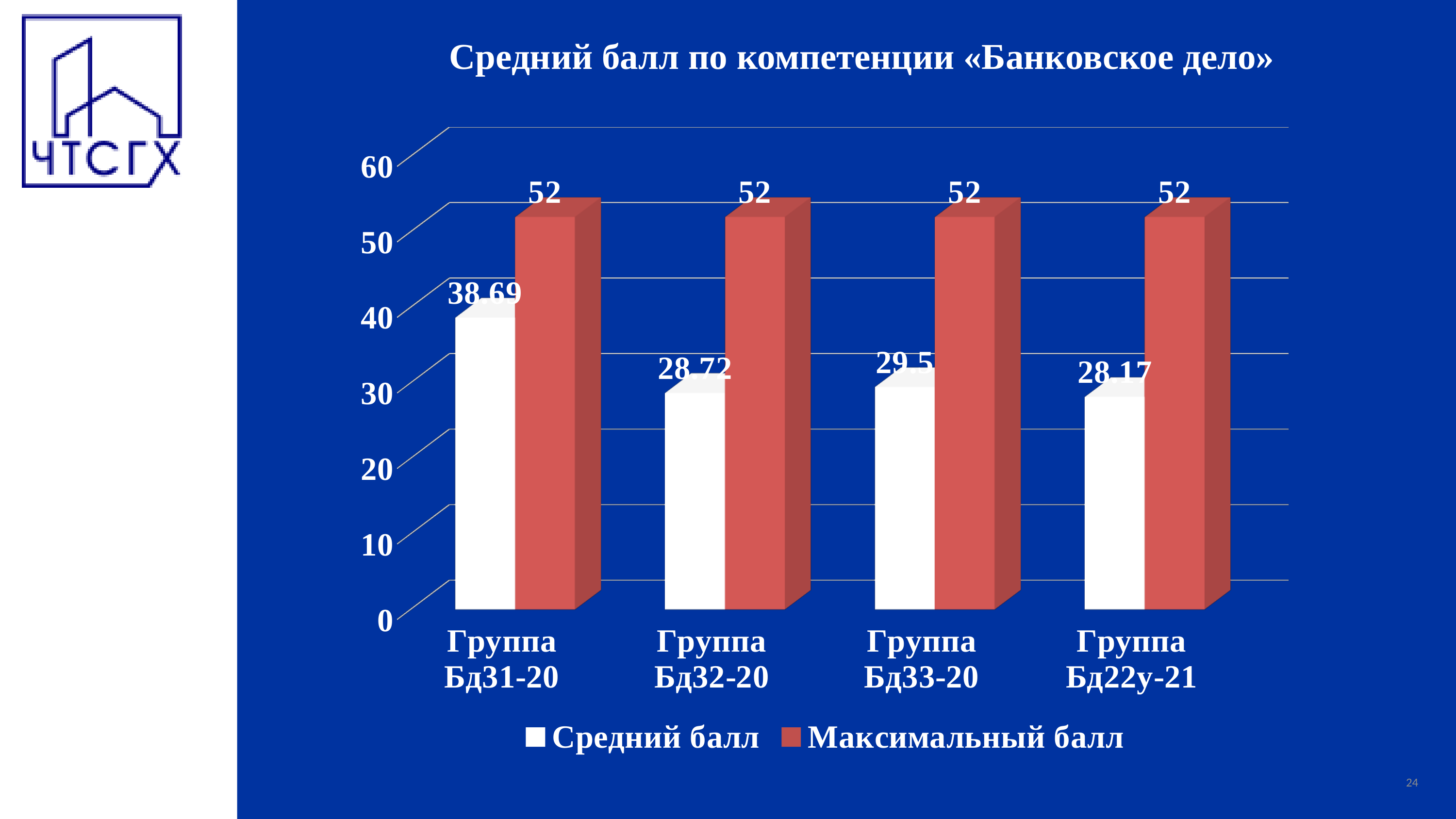
Which is larger: the Средний балл for Группа Бд32-20 or for Группа Бд33-20? Группа Бд33-20 What is the Средний балл for Группа Бд32-20? 28.72 What is the Средний балл for Группа Бд31-20? 38.69 What kind of chart is shown on the slide? Bar chart What is the Средний балл for Группа Бд33-20? 29.5 Which group has the lowest Средний балл? Группа Бд22у-21 How many series does the legend list? 2 Which group has the highest Средний балл? Группа Бд31-20 What is the Средний балл for Группа Бд22у-21? 28.17 What is the difference between the Максимальный балл and the Средний балл for Группа Бд31-20? 13.31 What is the Максимальный балл for Группа Бд33-20? 52 How many groups are shown on the x axis? 4